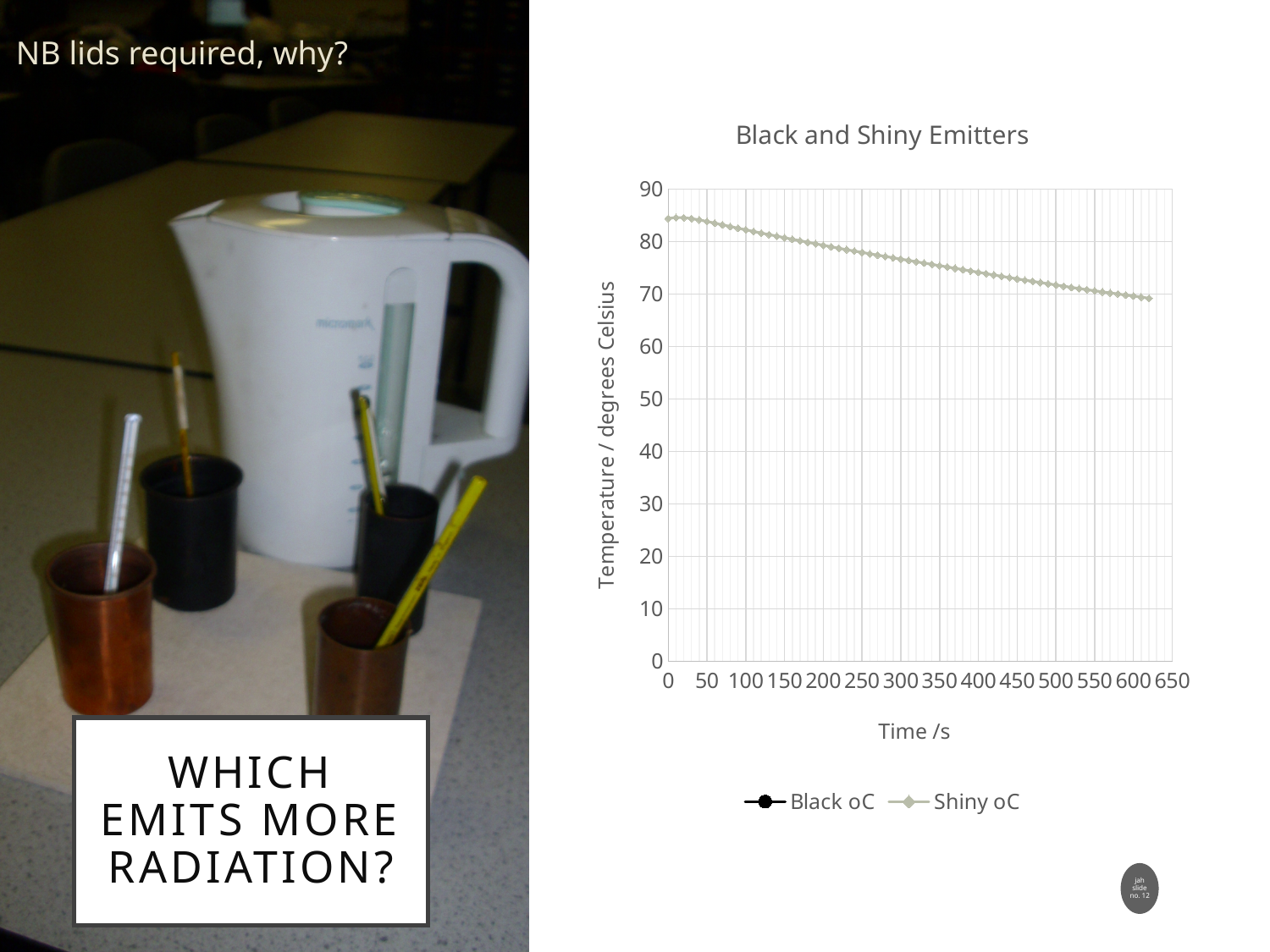
Is the Shiny oC value at time 300 s greater or less than 70? greater Is the Shiny oC value at time 0 s greater or less than 90? less Is the Shiny oC value at time 0 s greater or less than 80? greater What is the title of the chart? Black and Shiny Emitters What kind of chart is shown on the slide? line chart Does the Shiny oC series rise or fall as time increases along the x axis? fall How many series does the chart's legend list? 2 What is the label on the vertical axis of the chart? Temperature / degrees Celsius Which is larger for the Shiny oC series: the value at 0 s or the value at 600 s? the value at 0 s